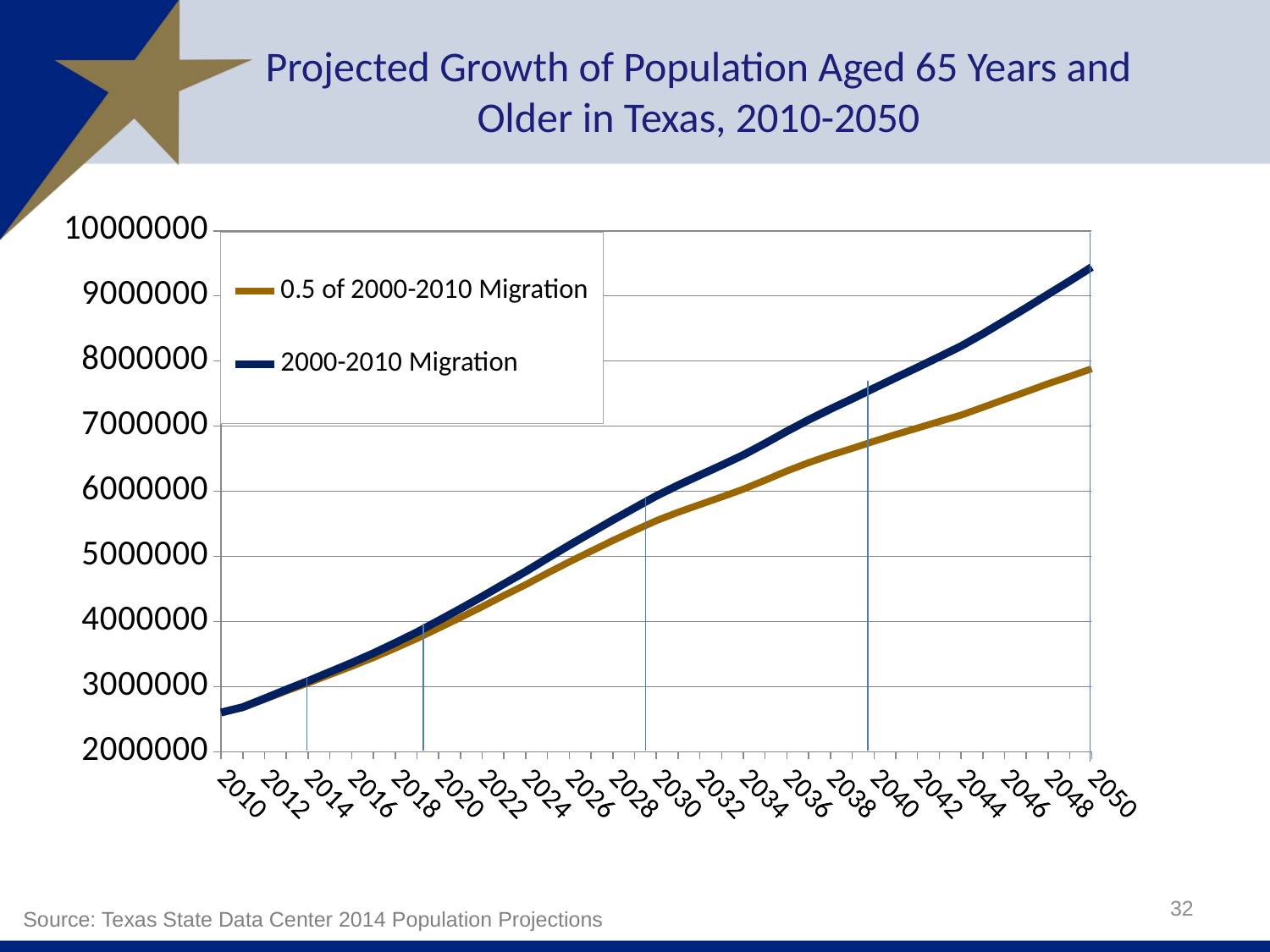
Is the value for the 2000-2010 Migration series in 2040 greater or less than 7000000? greater Is the value for the 0.5 of 2000-2010 Migration series in 2050 greater or less than 8000000? less Do the values for the 0.5 of 2000-2010 Migration series rise or fall from 2010 to 2050? Rise What is the title of the chart? Projected Growth of Population Aged 65 Years and Older in Texas, 2010-2050 How many year labels are shown on the x axis? 21 Is the value for the 0.5 of 2000-2010 Migration series in 2040 greater or less than 7000000? less Do the values for the 2000-2010 Migration series rise or fall from 2010 to 2050? Rise Which series is drawn in dark blue? 2000-2010 Migration In 2050, which series has the higher value, 2000-2010 Migration or 0.5 of 2000-2010 Migration? 2000-2010 Migration What kind of chart is shown on the slide? Line chart How many series does the legend list? 2